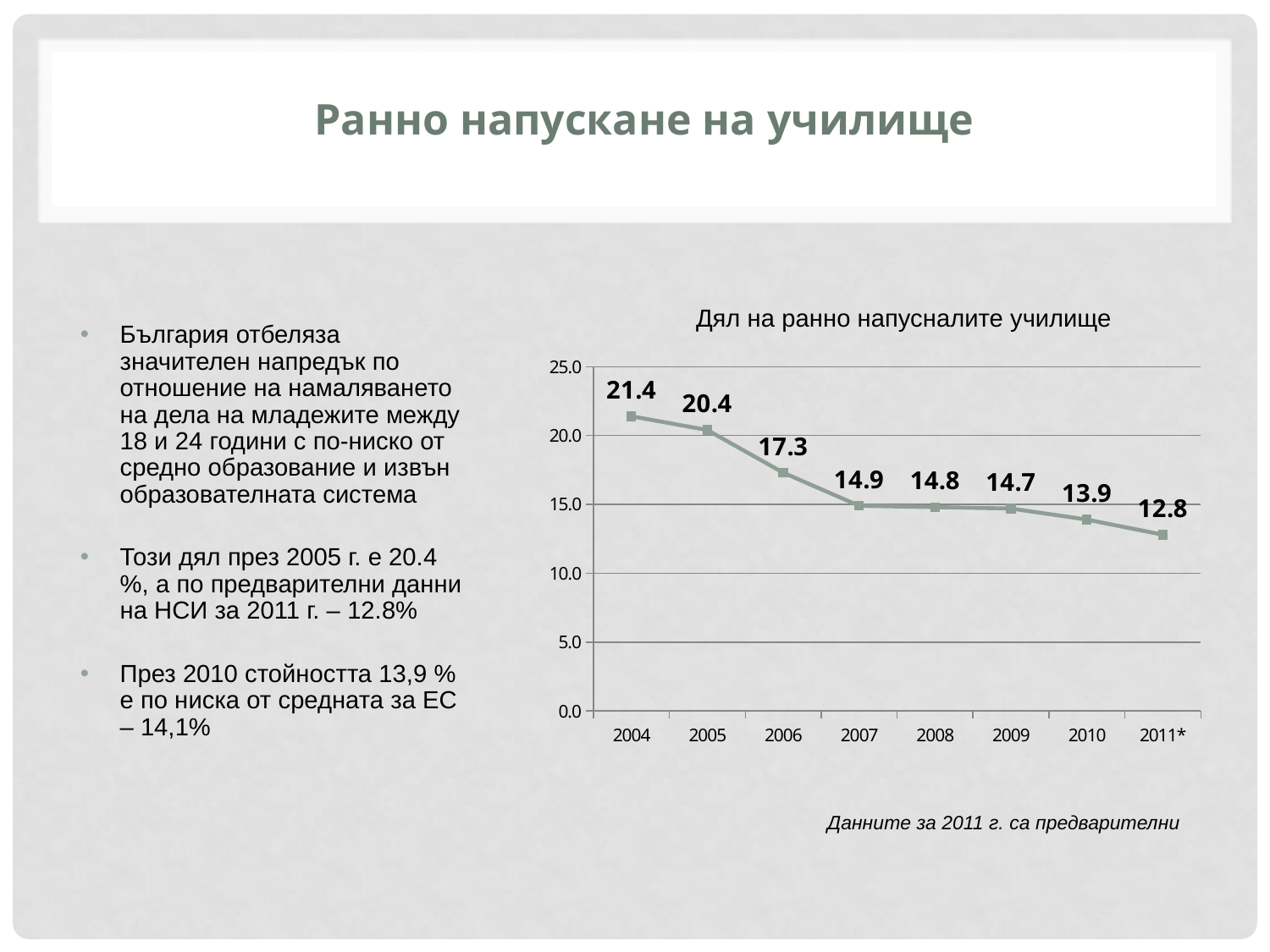
What is the difference between the values for 2005 and 2006? 3.1 Which year has the lowest value? 2011* What is the title of the chart? Дял на ранно напусналите училище How many years are plotted on the chart? 8 What kind of chart is shown? line chart What is the value for 2011*? 12.8 Which is larger, the value for 2009 or the value for 2010? 2009 Is the value for 2006 greater or less than 15.0? greater Which year has the highest value? 2004 What is the value for 2004? 21.4 Do the values rise or fall from 2004 to 2011*? fall What is the value for 2007? 14.9